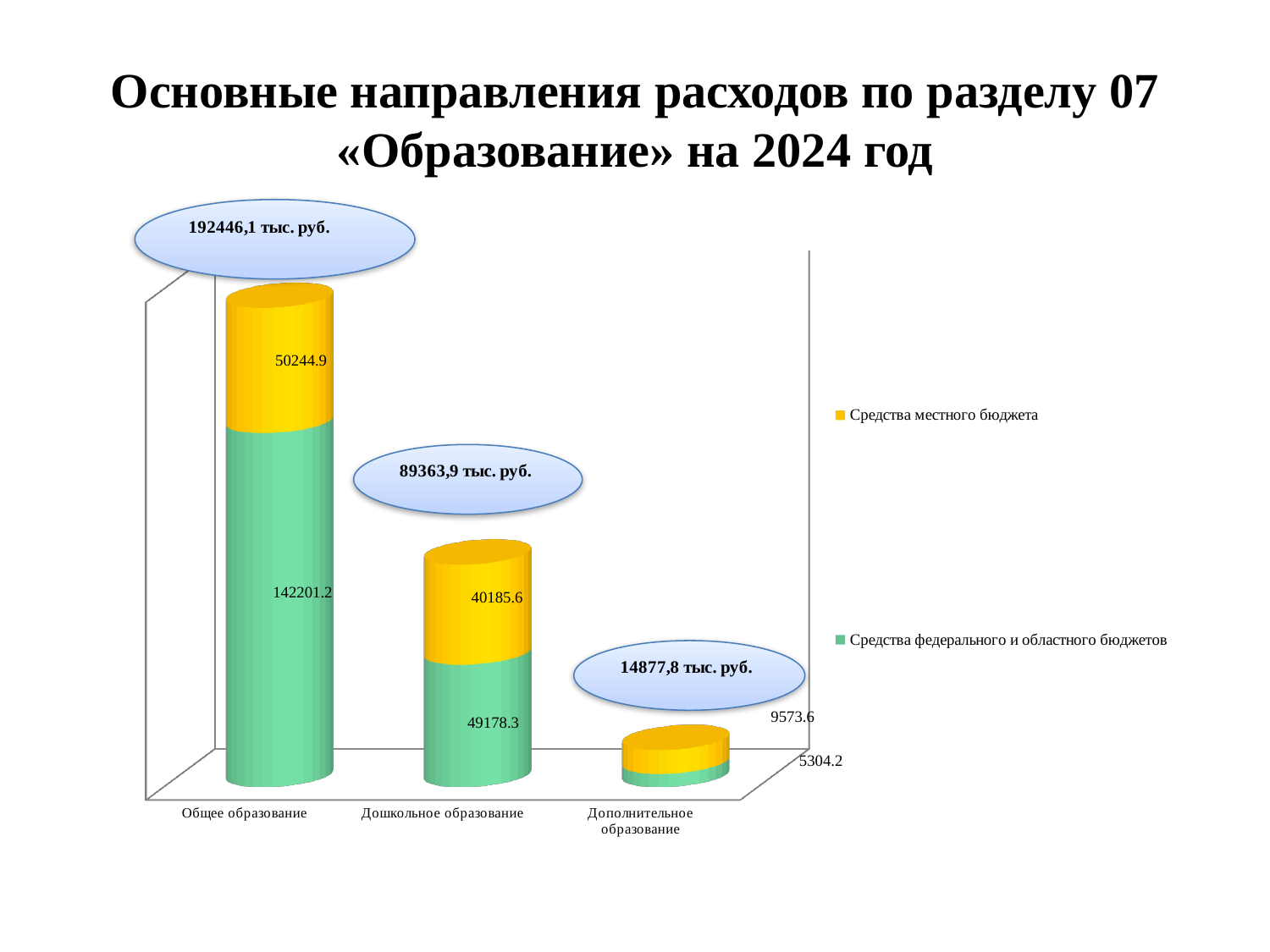
What kind of chart is shown on the slide? Stacked bar chart What is the value of Средства местного бюджета for Дошкольное образование? 40185.6 What is the value of Средства федерального и областного бюджетов for Дошкольное образование? 49178.3 What is the total shown in the callout for Дополнительное образование? 14877,8 тыс. руб. What is the difference between Средства федерального и областного бюджетов and Средства местного бюджета for Общее образование? 91956.3 How many series does the legend list? 2 How many categories are shown on the x axis of the chart? 3 What is the total shown in the callout for Общее образование? 192446,1 тыс. руб. Which category has the lowest total expenditure? Дополнительное образование What is the value of Средства местного бюджета for Общее образование? 50244.9 What is the value of Средства федерального и областного бюджетов for Общее образование? 142201.2 Which category has the highest total expenditure? Общее образование